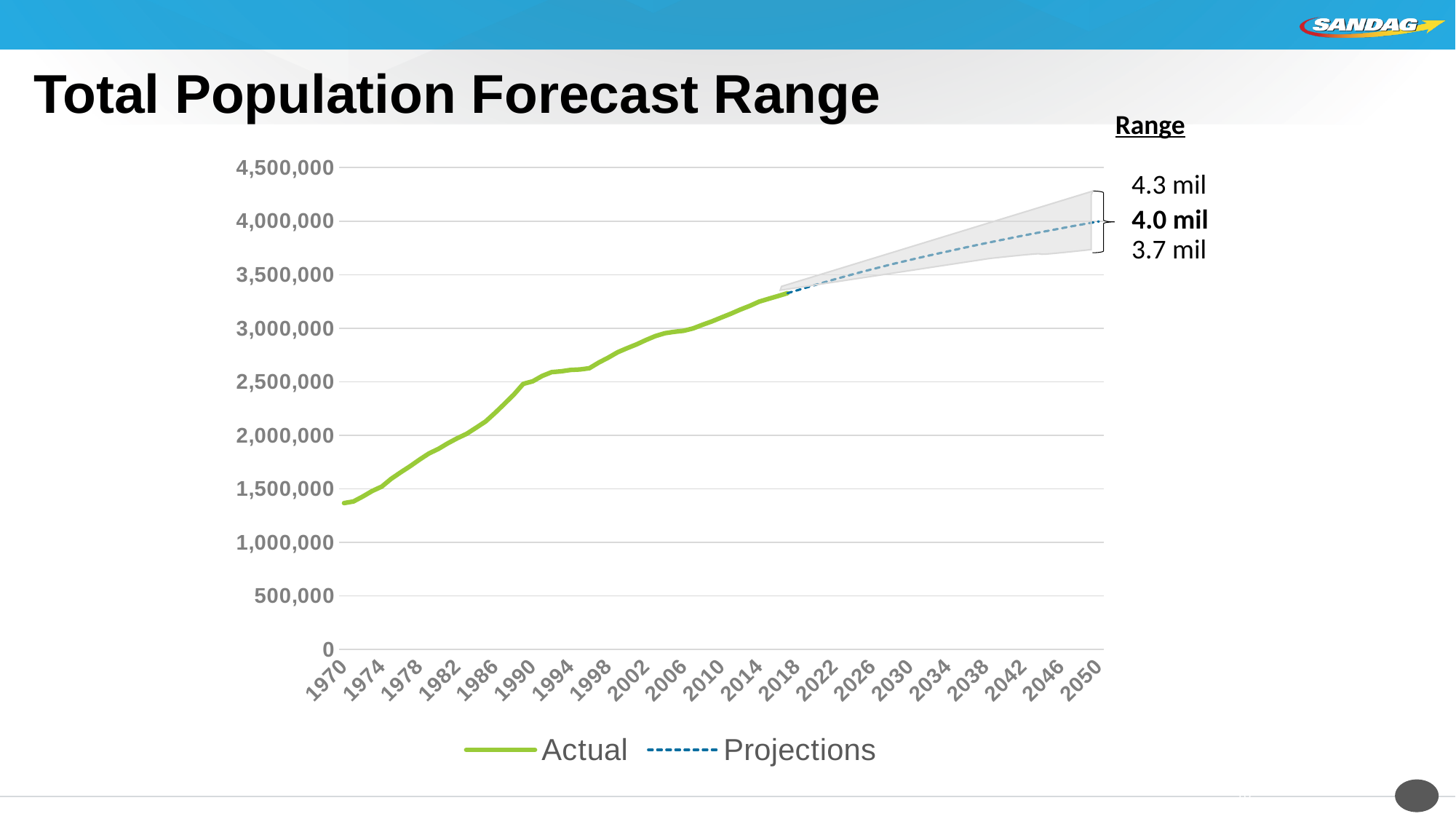
Is the Actual population value for 2018 greater or less than 3,000,000? greater How many series does the legend list? 2 What is the upper end of the forecast range shown for 2050? 4.3 mil What is the title of the chart on the slide? Total Population Forecast Range What is the central projected population value shown for 2050? 4.0 mil What are the two series named in the legend? Actual and Projections What is the lower end of the forecast range shown for 2050? 3.7 mil What is the difference between the upper and lower ends of the 2050 forecast range? 0.6 mil Is the Actual population value for 1970 greater or less than 1,500,000? less How many year labels are shown on the x axis? 21 What kind of chart is shown on the slide? line chart Does the Actual population line rise or fall from 1970 to 2018? rises